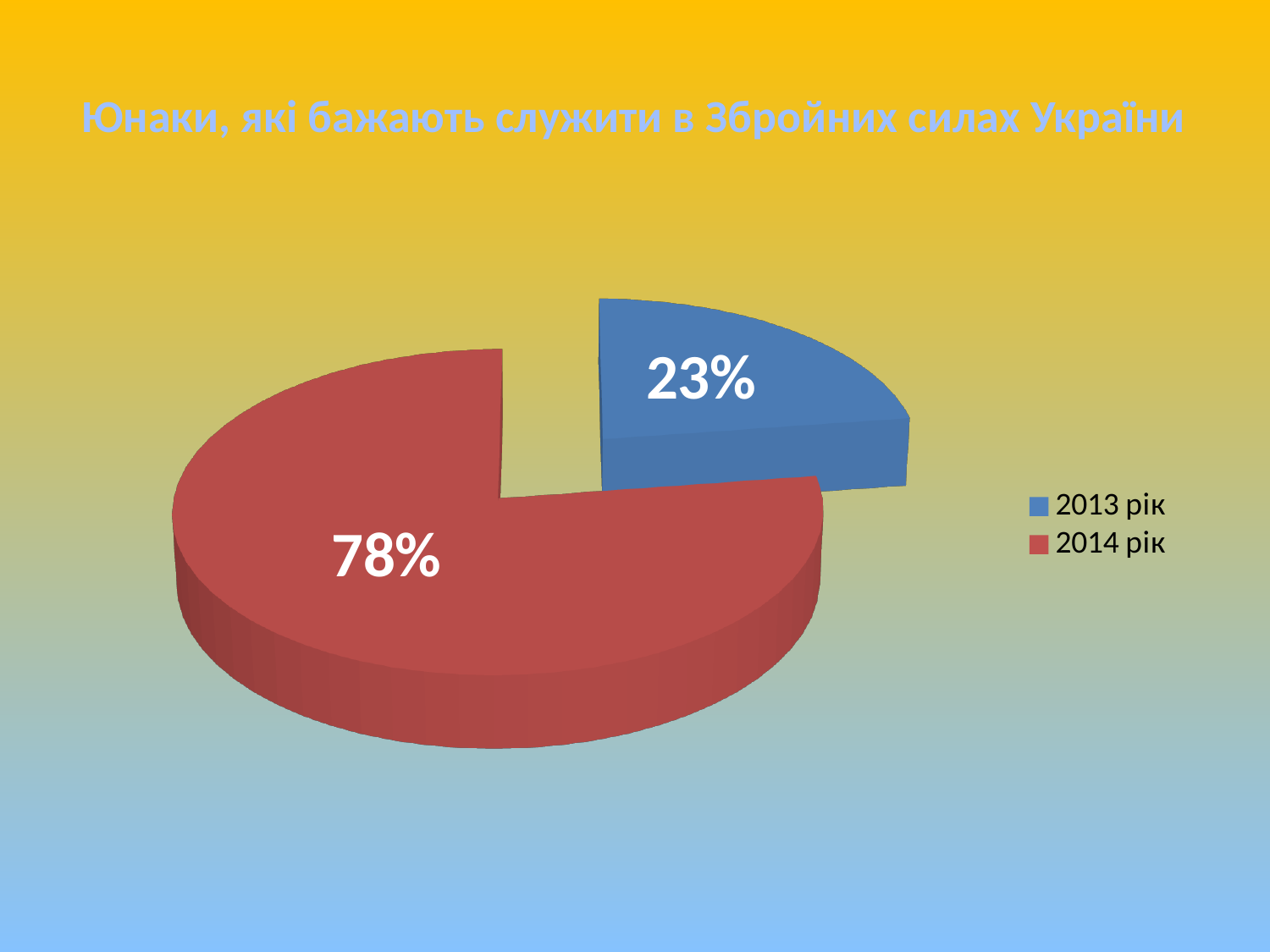
Which category has the smallest slice? 2013 рік What is the title of the chart? Юнаки, які бажають служити в Збройних силах України What is the value for 2013 рік? 23% What colour is the slice for 2014 рік? red What is the difference between the values for 2014 рік and 2013 рік? 55% Which is larger, the value for 2013 рік or 2014 рік? 2014 рік How many slices does the pie chart have? 2 Which category has the largest slice? 2014 рік What is the value for 2014 рік? 78% What kind of chart is shown on the slide? pie chart How many entries does the legend list? 2